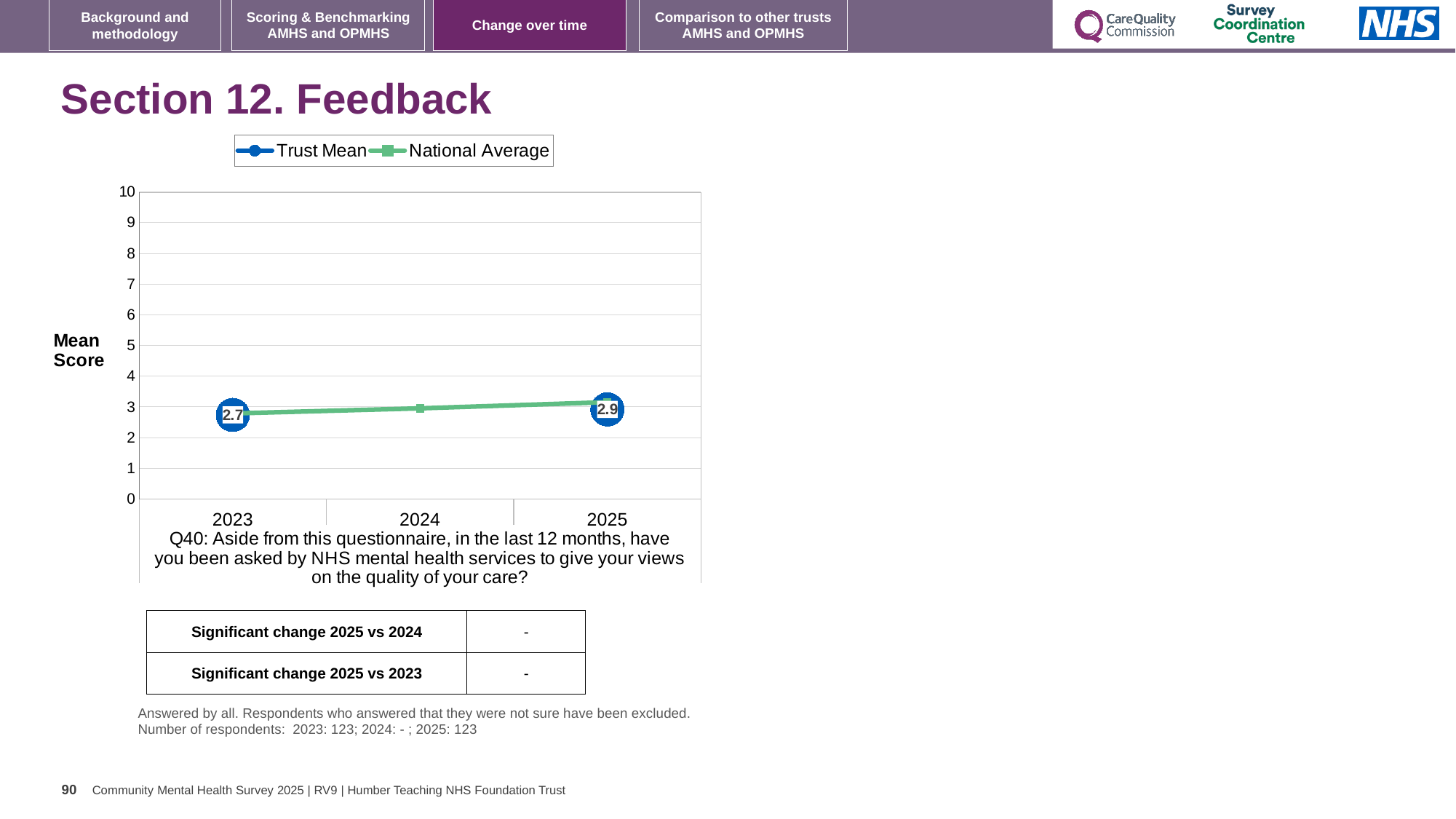
Which year has the higher Trust Mean, 2023 or 2025? 2025 By how much did the Trust Mean change from 2023 to 2025? 0.2 Does the Trust Mean rise or fall from 2023 to 2025? rise What kind of chart is shown on the slide? line chart How many series does the legend list? 2 What is the Trust Mean value for 2025? 2.9 Is the National Average value for 2024 greater or less than 5? less What is the label on the y axis of the chart? Mean Score How many years are shown on the x axis? 3 What are the two series named in the legend? Trust Mean and National Average Is the Trust Mean value for 2023 greater or less than 4? less What is the Trust Mean value for 2023? 2.7